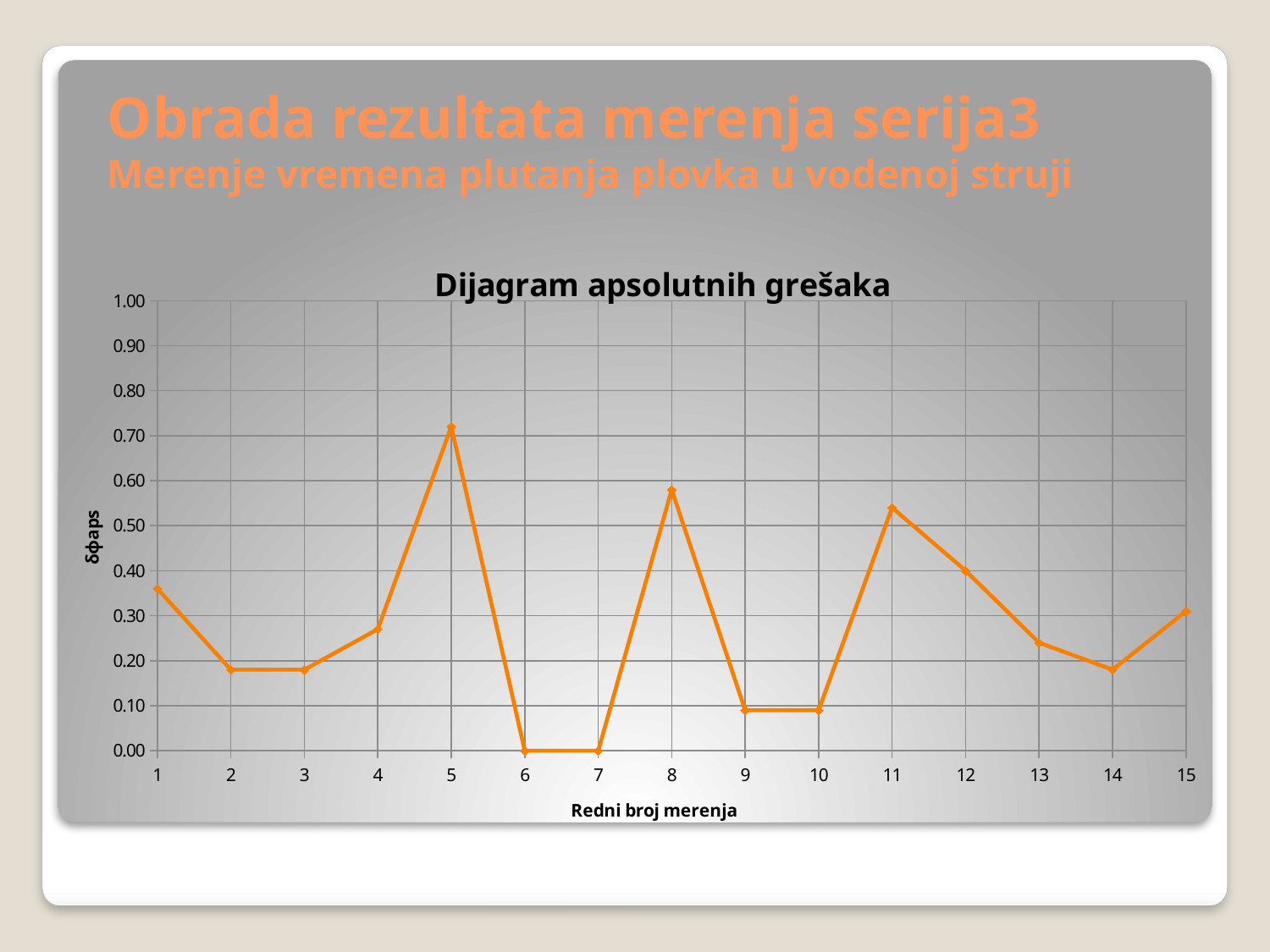
What is the value for measurement 6? 0.00 Which has the larger value, measurement 5 or measurement 8? measurement 5 Is the value for measurement 9 greater or less than 0.20? less What is the value for measurement 7? 0.00 What is the title of the chart? Dijagram apsolutnih grešaka Do the values rise or fall from measurement 11 to measurement 14? fall How many measurement points are plotted on the chart? 15 Is the value for measurement 1 greater or less than 0.40? less Which measurement number has the highest absolute error? 5 What kind of chart is shown on the slide? line chart Is the value for measurement 5 greater or less than 0.60? greater What is the label of the x axis? Redni broj merenja